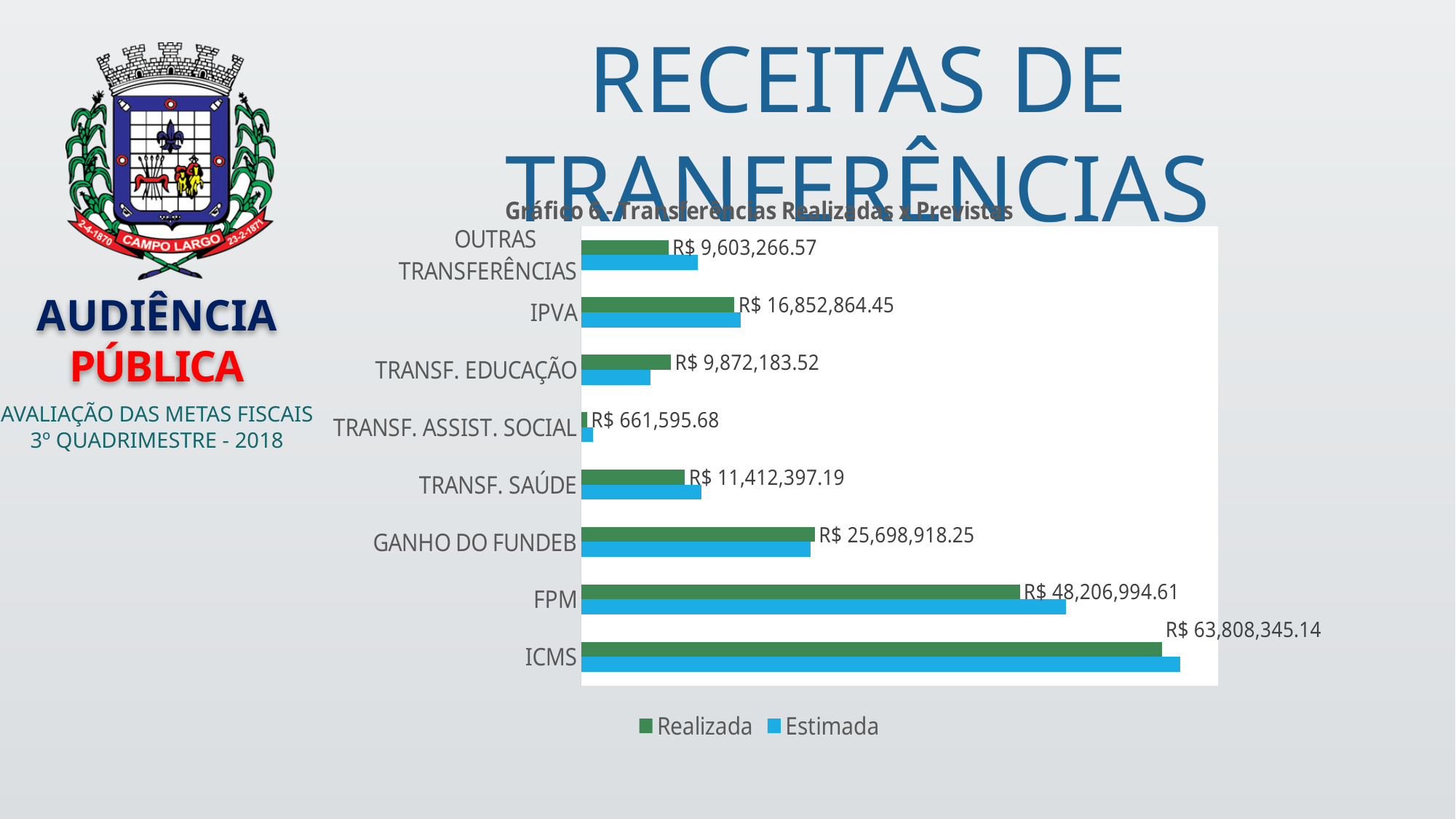
What is the Realizada value for GANHO DO FUNDEB? R$ 25,698,918.25 What is the Realizada value for IPVA? R$ 16,852,864.45 For TRANSF. EDUCAÇÃO, which is larger: the Realizada bar or the Estimada bar? Realizada What is the Realizada value for FPM? R$ 48,206,994.61 What kind of chart is shown on the slide? Bar chart Which category has the lowest Realizada value? TRANSF. ASSIST. SOCIAL What is the difference between the Realizada values for ICMS and FPM? R$ 15,601,350.53 Which category has the highest Realizada value? ICMS For ICMS, which is larger: the Realizada bar or the Estimada bar? Estimada What is the Realizada value for TRANSF. SAÚDE? R$ 11,412,397.19 How many categories are shown on the chart? 8 How many series does the legend list? 2